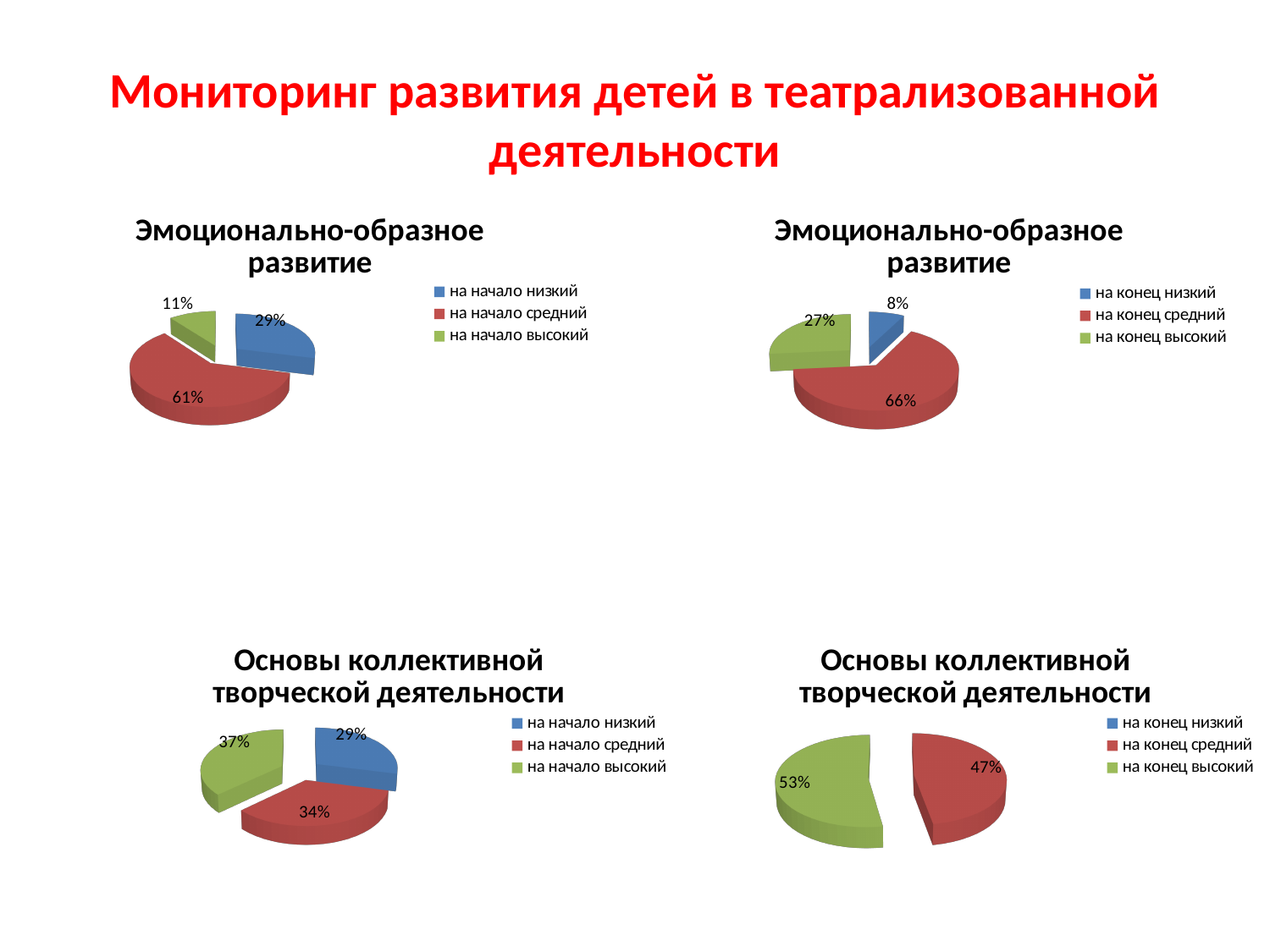
In the bottom-right pie chart (Основы коллективной творческой деятельности, на конец), what share is labelled for 'на конец высокий'? 53% In the top-right pie chart (Эмоционально-образное развитие, на конец), what share is labelled for 'на конец низкий'? 8% What type of chart is the bottom-left chart (Основы коллективной творческой деятельности, на начало)? Pie chart In the top-left pie chart (Эмоционально-образное развитие, на начало), what is the difference between the 'на начало средний' and 'на начало низкий' shares? 32% In the bottom-left pie chart (Основы коллективной творческой деятельности, на начало), which category has the largest slice? на начало высокий In the top-left pie chart (Эмоционально-образное развитие, на начало), what share is labelled for 'на начало высокий'? 11% How many entries does the legend of the top-right pie chart (Эмоционально-образное развитие, на конец) list? 3 In the bottom-left pie chart (Основы коллективной творческой деятельности, на начало), what share is labelled for 'на начало средний'? 34% In the top-right pie chart (Эмоционально-образное развитие, на конец), which category has the largest slice? на конец средний In the top-right pie chart (Эмоционально-образное развитие, на конец), which category has the smallest slice? на конец низкий In the top-left pie chart (Эмоционально-образное развитие, на начало), what share is labelled for 'на начало средний'? 61% In the bottom-right pie chart (Основы коллективной творческой деятельности, на конец), what is the difference between the 'на конец высокий' and 'на конец средний' shares? 6%